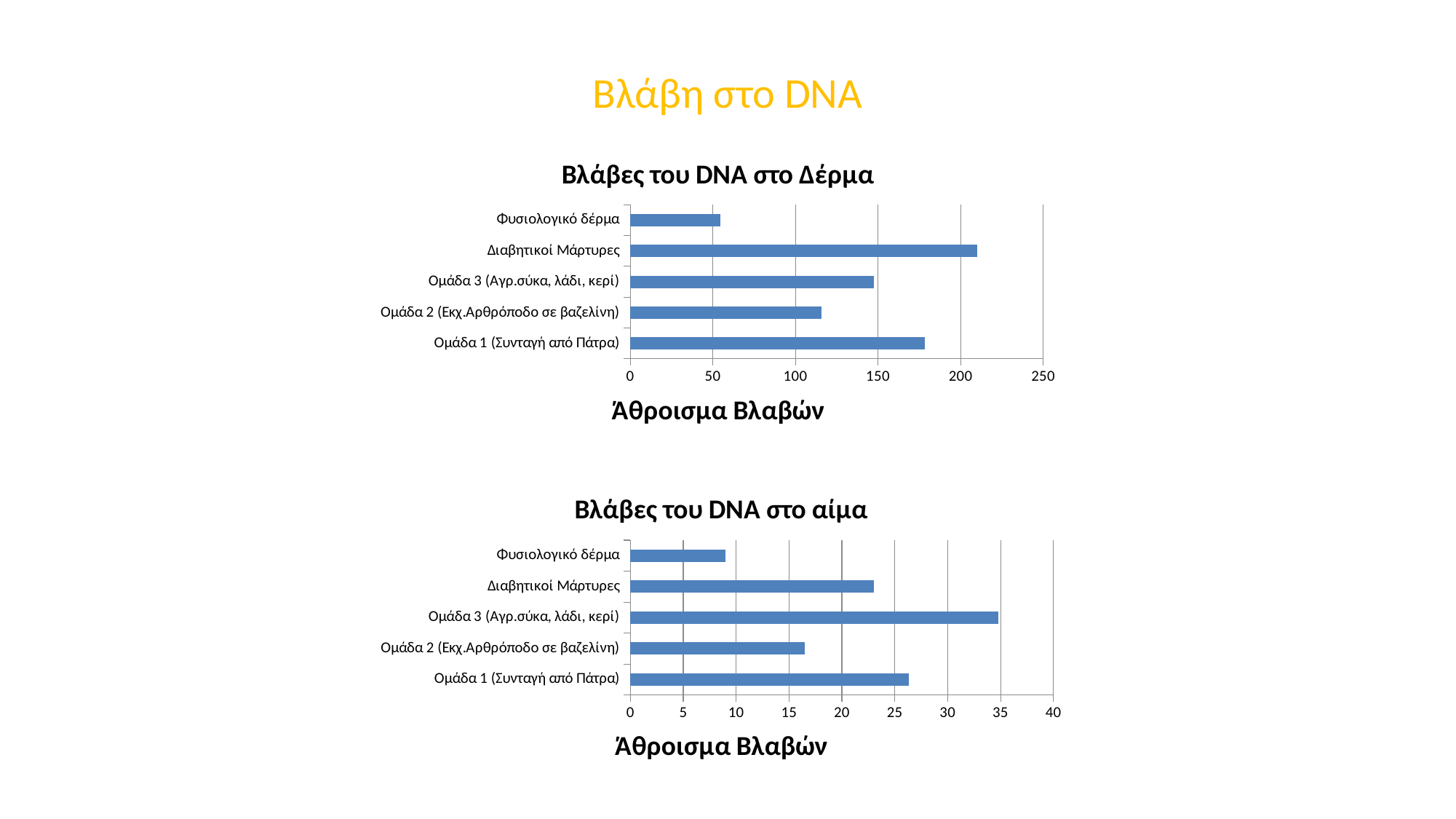
How many categories are shown in the "Βλάβες του DNA στο Δέρμα" chart? 5 In the "Βλάβες του DNA στο Δέρμα" chart, is the value for Ομάδα 2 (Εκχ.Αρθρόποδο σε βαζελίνη) greater or less than 150? less In the "Βλάβες του DNA στο αίμα" chart, is the value for Διαβητικοί Μάρτυρες greater or less than 20? greater In the "Βλάβες του DNA στο Δέρμα" chart, which category has the highest value? Διαβητικοί Μάρτυρες In the "Βλάβες του DNA στο Δέρμα" chart, which is larger: Ομάδα 3 (Αγρ.σύκα, λάδι, κερί) or Ομάδα 2 (Εκχ.Αρθρόποδο σε βαζελίνη)? Ομάδα 3 (Αγρ.σύκα, λάδι, κερί) In the "Βλάβες του DNA στο Δέρμα" chart, is the value for Ομάδα 1 (Συνταγή από Πάτρα) greater or less than 150? greater In the "Βλάβες του DNA στο αίμα" chart, which category has the lowest value? Φυσιολογικό δέρμα In the "Βλάβες του DNA στο αίμα" chart, which is larger: Ομάδα 1 (Συνταγή από Πάτρα) or Ομάδα 2 (Εκχ.Αρθρόποδο σε βαζελίνη)? Ομάδα 1 (Συνταγή από Πάτρα) What kind of chart is "Βλάβες του DNA στο Δέρμα"? bar chart In the "Βλάβες του DNA στο Δέρμα" chart, which category has the lowest value? Φυσιολογικό δέρμα In the "Βλάβες του DNA στο αίμα" chart, which category has the highest value? Ομάδα 3 (Αγρ.σύκα, λάδι, κερί) What is the x-axis title of the "Βλάβες του DNA στο αίμα" chart? Άθροισμα Βλαβών